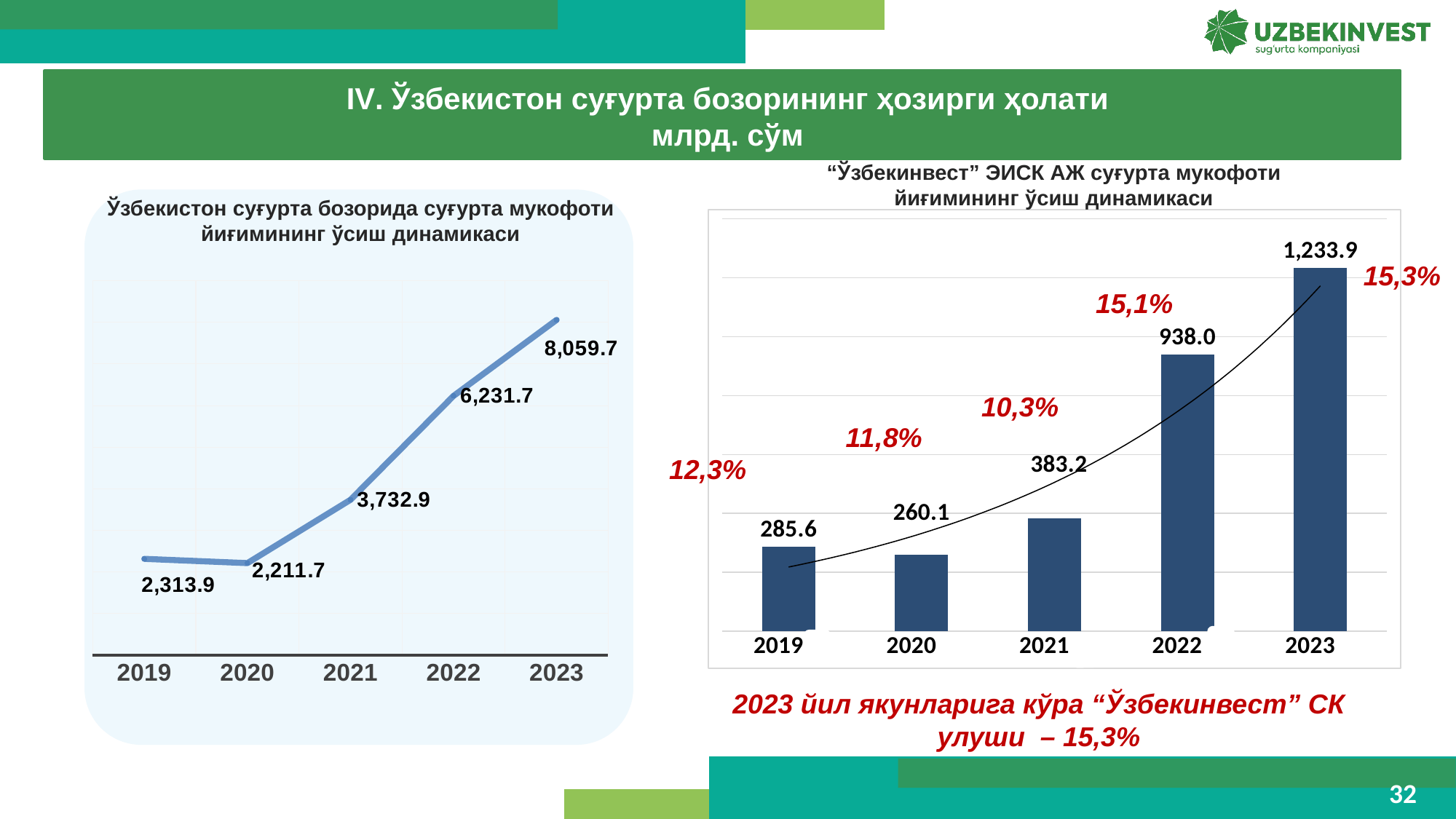
In the right chart, what percentage is shown next to the 2023 bar? 15,3% In the left chart, which is larger, the value for 2021 or the value for 2022? 2022 In the left chart, what is the difference between the values for 2019 and 2020? 102.2 In the right chart, what is the value for 2022? 938.0 In the left chart, what is the value for 2023? 8,059.7 In the left chart, what is the value for 2020? 2,211.7 In the left chart, which year has the highest value? 2023 What kind of chart is the left chart? line chart In the right chart, what is the difference between the values for 2023 and 2022? 295.9 In the right chart, what is the value for 2019? 285.6 How many years are shown on the x axis of the right chart? 5 In the right chart, which year has the lowest value? 2020